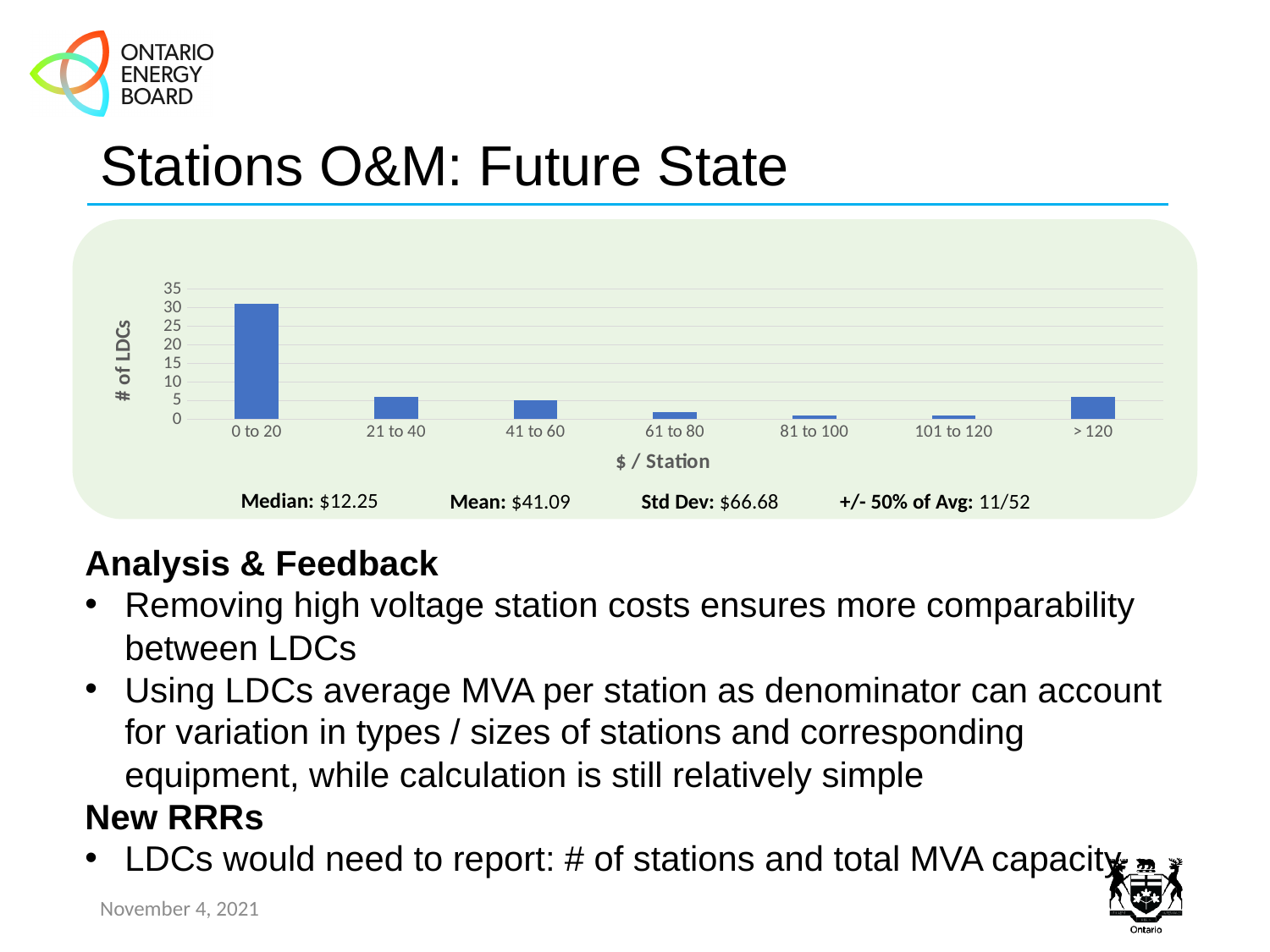
How many $ / Station categories are shown on the x axis of the chart? 7 Which $ / Station category has the highest number of LDCs? 0 to 20 Is the number of LDCs in the > 120 category greater or less than 10? less What kind of chart is shown on the slide? bar chart Is the number of LDCs in the 0 to 20 category greater or less than 25? greater Is the number of LDCs in the 21 to 40 category greater or less than 10? less What is the title of the y axis of the chart? # of LDCs Which has more LDCs: the 0 to 20 category or the 21 to 40 category? 0 to 20 What is the title of the x axis of the chart? $ / Station Which has more LDCs: the 21 to 40 category or the 61 to 80 category? 21 to 40